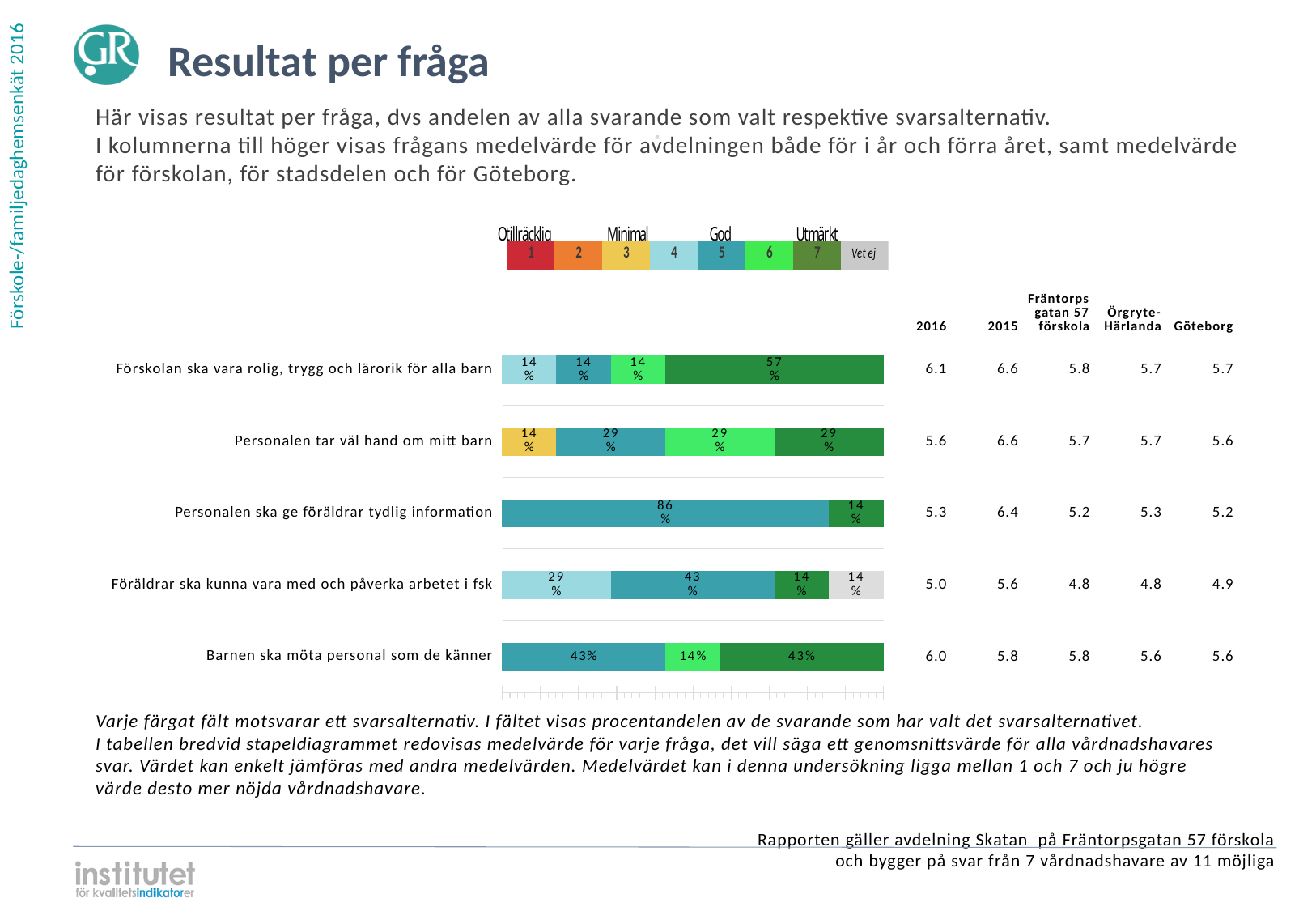
How many questions (categories) are plotted in the bar chart? 5 What percentage of respondents chose answer 7 (Utmärkt) for 'Förskolan ska vara rolig, trygg och lärorik för alla barn'? 57% For 'Barnen ska möta personal som de känner', what is the difference between the share choosing answer 5 and the share choosing answer 6? 29% How many entries does the colour legend above the chart list? 8 For 'Föräldrar ska kunna vara med och påverka arbetet i fsk', which is larger: the share choosing answer 4 or the share choosing answer 5? Answer 5 What is the 2016 mean value shown for 'Förskolan ska vara rolig, trygg och lärorik för alla barn'? 6.1 What kind of chart is shown on the slide? Stacked bar chart What percentage of respondents chose answer 3 for 'Personalen tar väl hand om mitt barn'? 14% What percentage of respondents answered 'Vet ej' for 'Föräldrar ska kunna vara med och påverka arbetet i fsk'? 14% Which question has the largest single segment in its bar? Personalen ska ge föräldrar tydlig information What percentage of respondents chose answer 5 for 'Personalen ska ge föräldrar tydlig information'? 86%